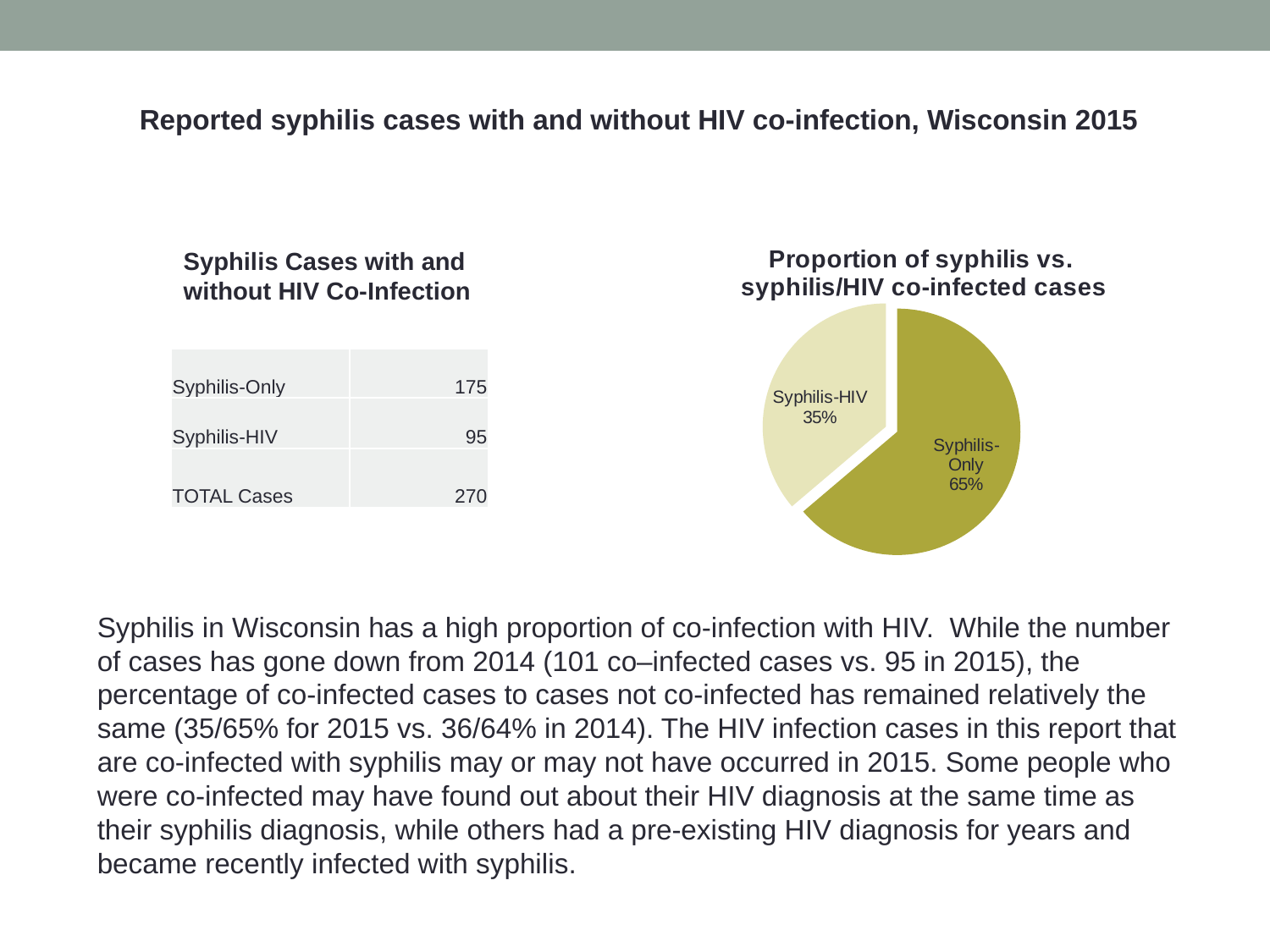
In the pie chart, what share of cases is Syphilis-HIV? 35% In the pie chart, is the Syphilis-Only share larger or smaller than the Syphilis-HIV share? larger What kind of chart is shown on the right side of the slide? pie chart In the pie chart, which slice is the largest? Syphilis-Only In the pie chart, what share of cases is Syphilis-Only? 65% In the pie chart, what is the difference in percentage points between the Syphilis-Only and Syphilis-HIV shares? 30 In the pie chart, which slice is the smallest? Syphilis-HIV In the pie chart, which slice is the darker olive colour? Syphilis-Only What is the title of the pie chart? Proportion of syphilis vs. syphilis/HIV co-infected cases How many slices does the pie chart have? 2